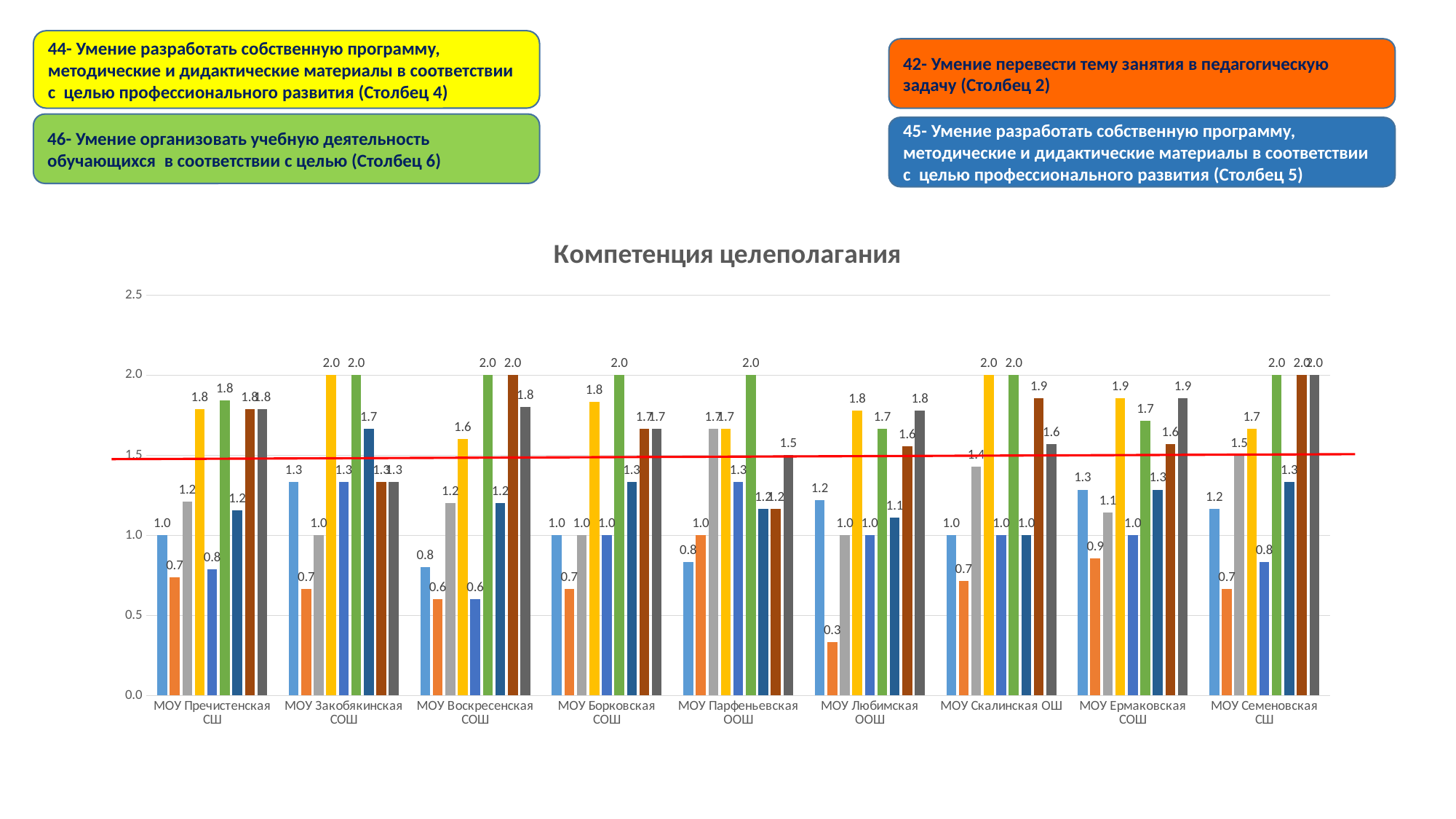
What is the title of the chart? Компетенция целеполагания What is the value of the orange bar for МОУ Любимская ООШ? 0.3 Which school has the highest orange bar? МОУ Парфеньевская ООШ What type of chart is shown on the slide? bar chart Which school has the lowest orange bar? МОУ Любимская ООШ Is the value of the gray bar for МОУ Скалинская ОШ greater or less than 1.5? less What is the difference between the light blue bar and the orange bar for МОУ Любимская ООШ? 0.9 How many schools (categories) are shown on the x axis of the chart? 9 What is the value of the yellow bar for МОУ Воскресенская СОШ? 1.6 At what value on the y axis is the red horizontal line drawn across the chart? 1.5 For МОУ Ермаковская СОШ, which is larger: the yellow bar or the green bar? the yellow bar What is the value of the light blue (first) bar for МОУ Закобякинская СОШ? 1.3